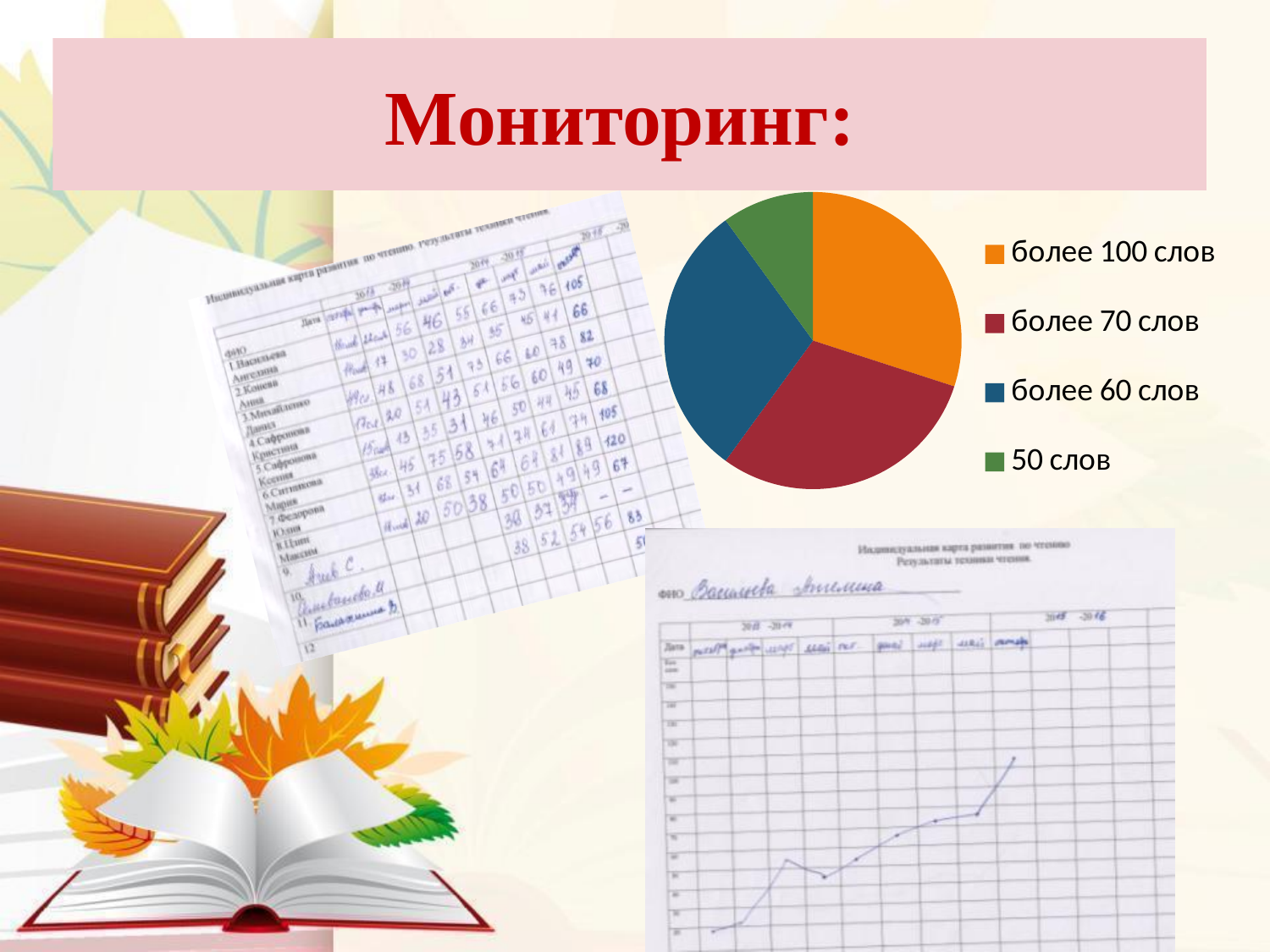
Which slice is larger in the pie chart: "более 100 слов" or "50 слов"? более 100 слов How many slices does the pie chart have? 4 Which slice is larger in the pie chart: "более 60 слов" or "50 слов"? более 60 слов How many entries does the legend of the pie chart list? 4 What kind of chart is shown on the slide? pie chart Which category has the smallest slice in the pie chart? 50 слов What colour is the "более 100 слов" slice in the pie chart? orange Which slice is larger in the pie chart: "более 70 слов" or "50 слов"? более 70 слов Which legend entry of the pie chart is shown in green? 50 слов